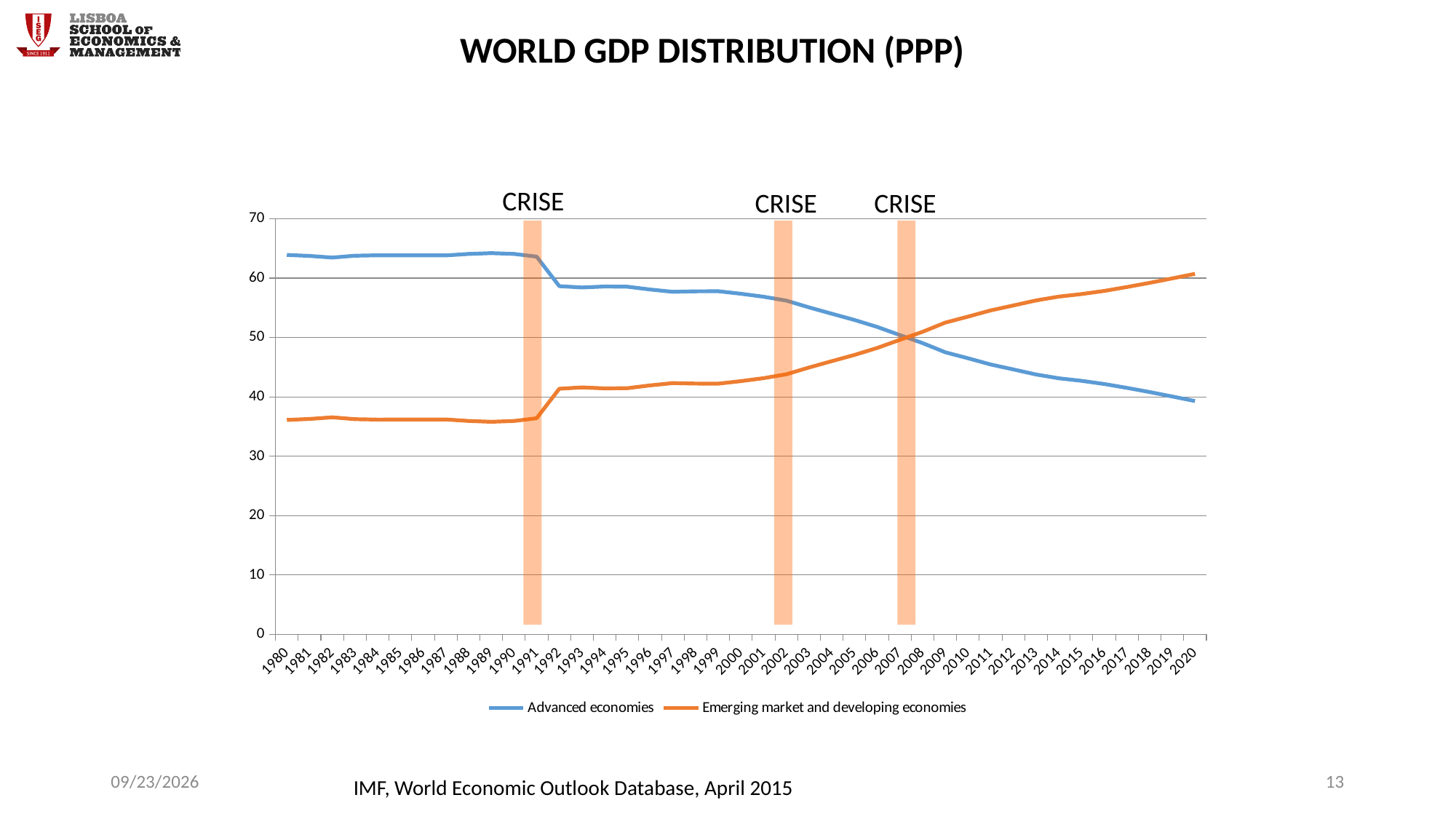
Does the Emerging market and developing economies line rise or fall from 1980 to 2020? Rise What is the title of the chart? WORLD GDP DISTRIBUTION (PPP) How many shaded bands labelled CRISE are marked on the chart? 3 How many series does the legend list? 2 How many years are plotted along the x axis? 41 Does the Advanced economies line rise or fall from 1980 to 2020? Fall What kind of chart is shown on the slide? Line chart Is the value for Advanced economies in 1980 greater or less than 60? greater In 1980, which series has the larger value: Advanced economies or Emerging market and developing economies? Advanced economies Is the value for Emerging market and developing economies in 1980 greater or less than 40? less Is the value for Emerging market and developing economies in 2020 greater or less than 50? greater In 2020, which series has the larger value: Advanced economies or Emerging market and developing economies? Emerging market and developing economies